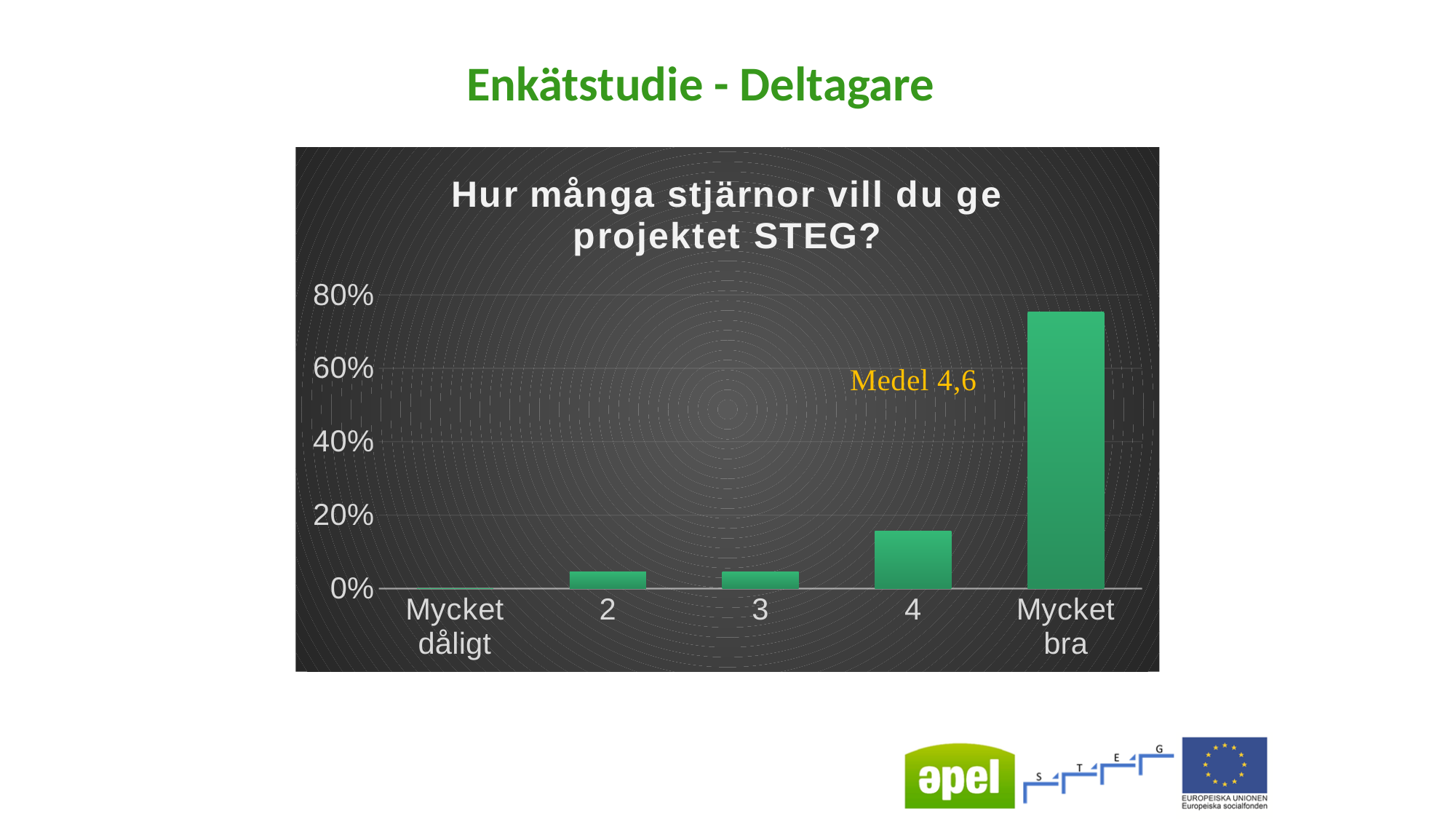
Is the value for 4 greater or less than 20%? less Which category has the lowest value in the chart? Mycket dåligt What kind of chart is shown on the slide? bar chart What average (Medel) value is annotated on the chart? 4,6 Which is larger, the value for Mycket bra or the value for 4? Mycket bra Which category has the highest value in the chart? Mycket bra Is the value for 2 greater or less than 20%? less What is the title of the chart? Hur många stjärnor vill du ge projektet STEG? Is the value for Mycket bra greater or less than 60%? greater Which is larger, the value for 4 or the value for 2? 4 How many categories are shown on the x axis of the chart? 5 Do the values generally rise or fall from Mycket dåligt to Mycket bra along the x axis? rise